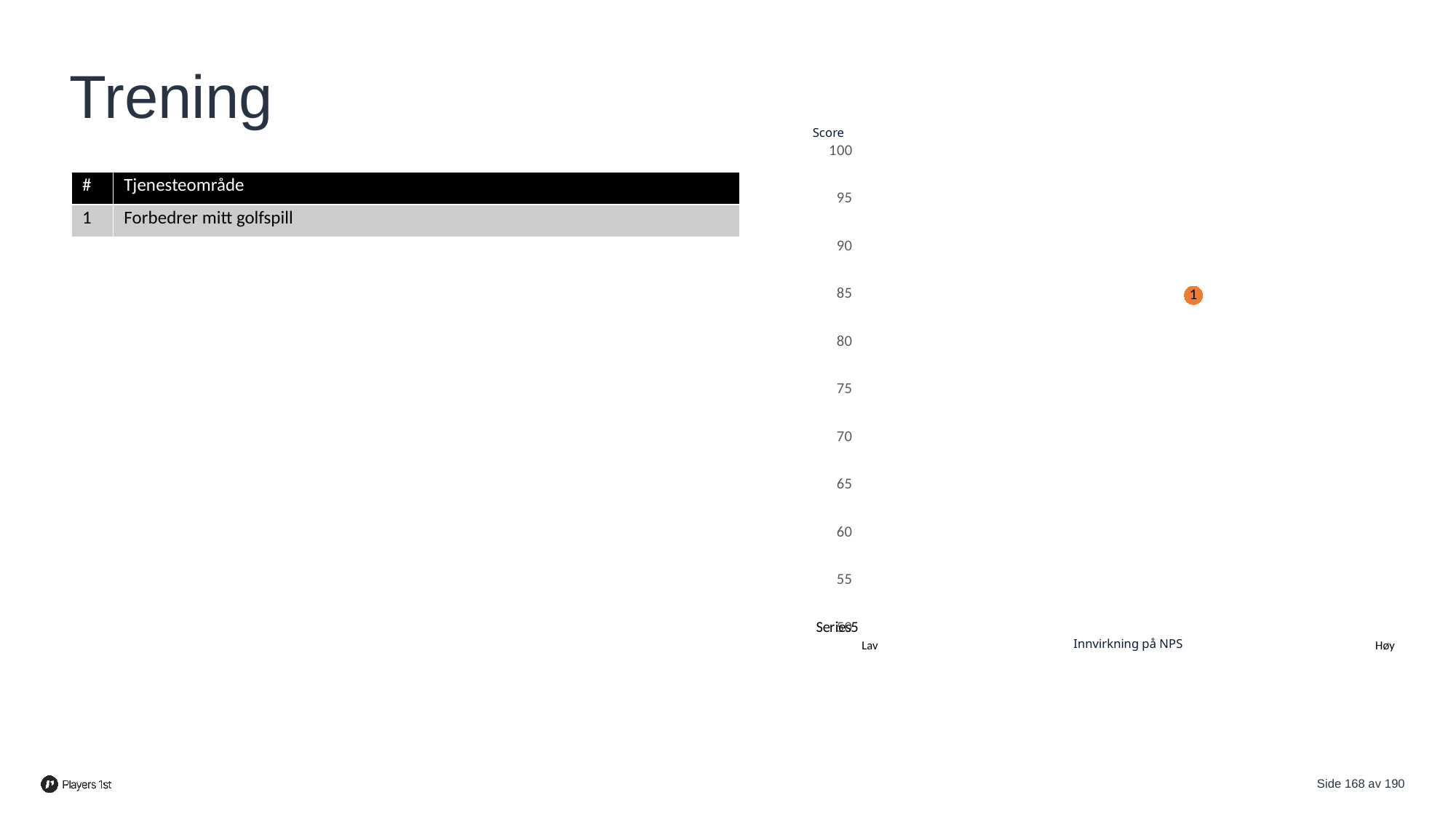
Is the Score value for point 1 greater or less than 80? greater What is the title of the vertical axis of the chart? Score Is the Score value for point 1 greater or less than 90? less What is the title of the horizontal axis of the chart? Innvirkning på NPS What kind of chart is shown on the slide? scatter chart How many data points are plotted on the chart? 1 According to the table, which service area does point 1 on the chart represent? Forbedrer mitt golfspill What is the highest tick value shown on the Score axis? 100